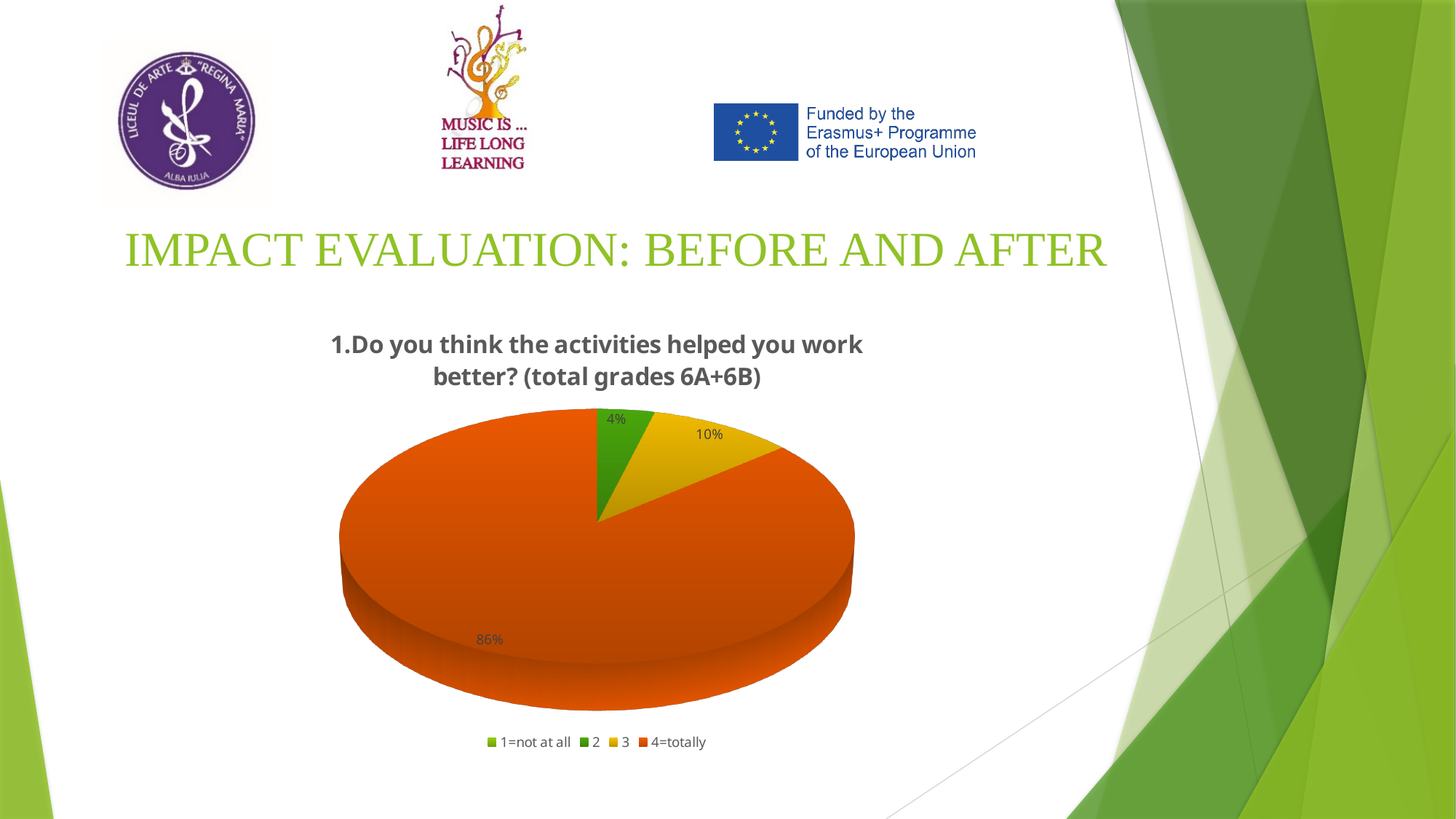
What percentage of the pie is labelled for the category 2? 4% What percentage of the pie is labelled for the category 3? 10% Which of the labelled slices is the smallest? 2 What share of the pie does the category 3 take? 10% What colour is the slice for 4=totally? orange What is the difference in percentage points between the slice for 4=totally and the slice for 3? 76 What percentage of the pie is labelled for the category 4=totally? 86% How many entries does the legend list? 4 What is the title of the chart? 1.Do you think the activities helped you work better? (total grades 6A+6B) Which category has the largest slice of the pie? 4=totally Which slice is larger, the one for 3 or the one for 2? 3 What kind of chart is shown on the slide? pie chart